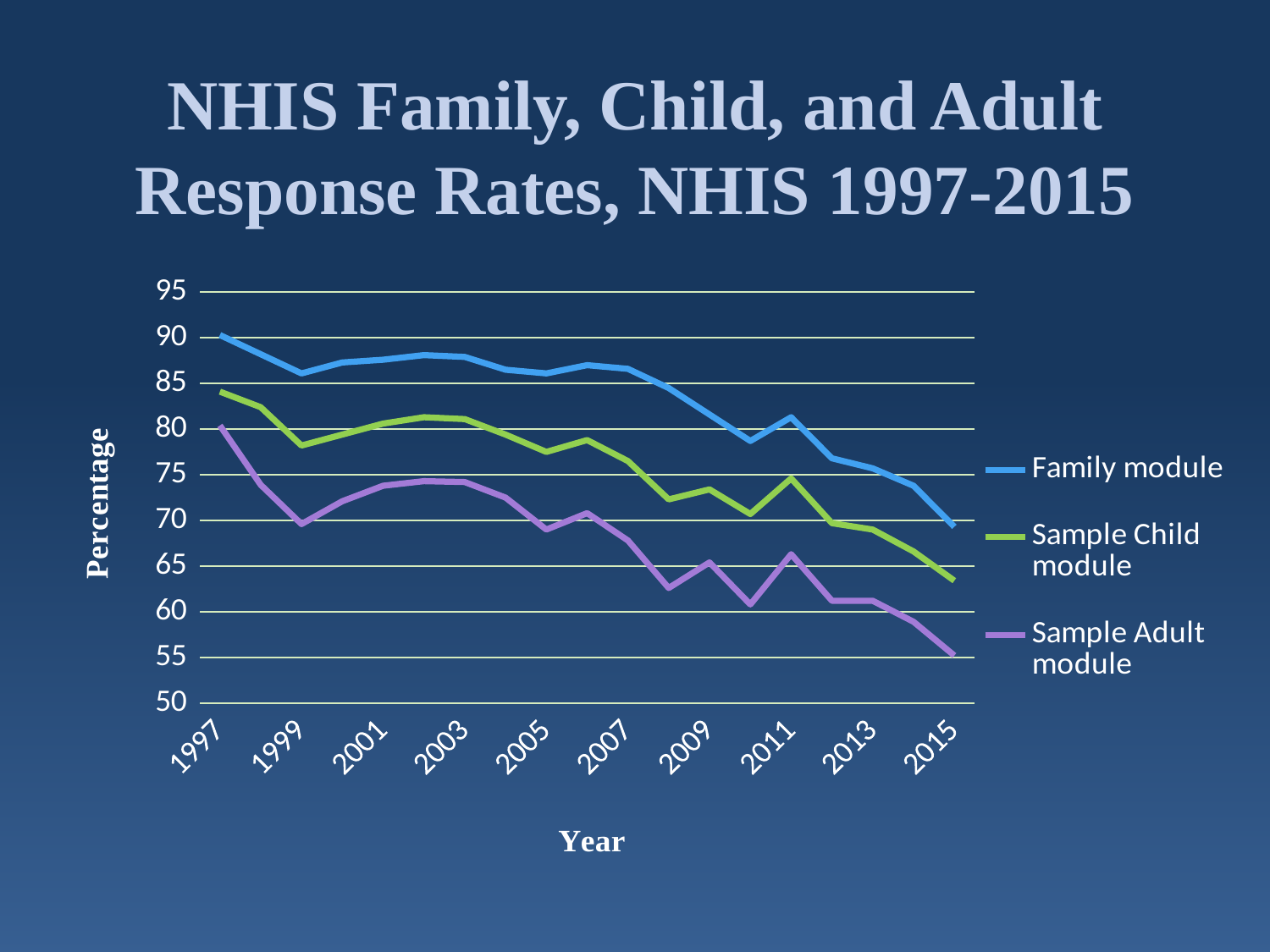
Which series has the lowest values across all years? Sample Adult module What is the label on the horizontal axis? Year Is the value for the Family module in 2015 greater or less than 75? less What kind of chart is shown on the slide? line chart Is the value for the Sample Child module in 1997 greater or less than 80? greater In 2005, which is larger: the Family module or the Sample Adult module? Family module What is the label on the vertical axis? Percentage How many series does the legend list? 3 Is the value for the Family module in 2003 greater or less than 85? greater Do the response rates generally rise or fall from 1997 to 2015? fall Which series has the highest values across all years? Family module